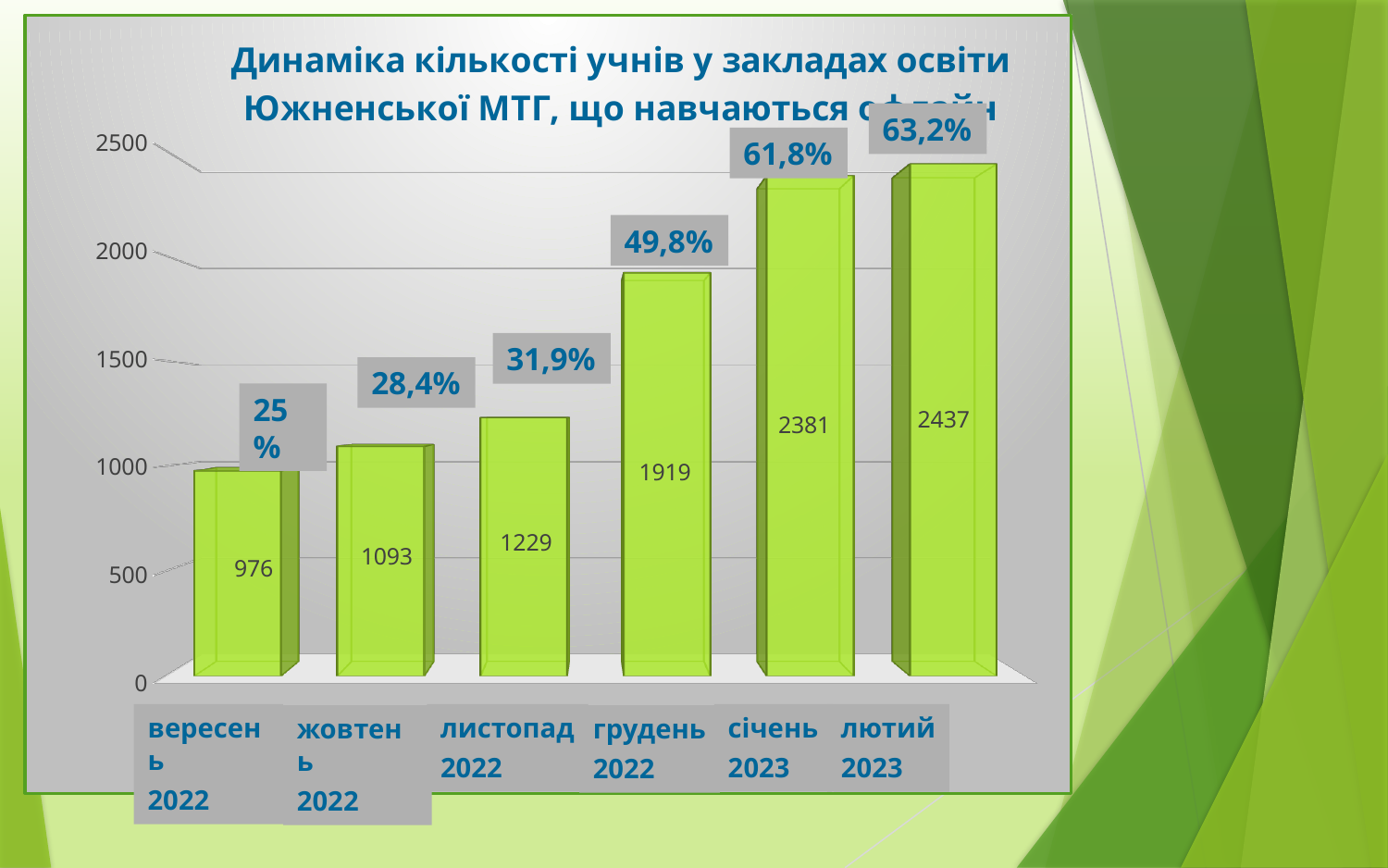
Which is larger, the number of students in жовтень 2022 or in листопад 2022? листопад 2022 What is the difference in the number of students between лютий 2023 and січень 2023? 56 What is the number of students shown for грудень 2022? 1919 What is the number of students shown for вересень 2022? 976 Which month has the lowest number of students? вересень 2022 Which month has the highest number of students? лютий 2023 What is the difference in the number of students between грудень 2022 and листопад 2022? 690 What percentage label is shown above the bar for січень 2023? 61,8% What kind of chart is shown on the slide? bar chart What percentage label is shown above the bar for листопад 2022? 31,9% How many months are shown on the x axis? 6 Is the value for грудень 2022 greater or less than 2000? less